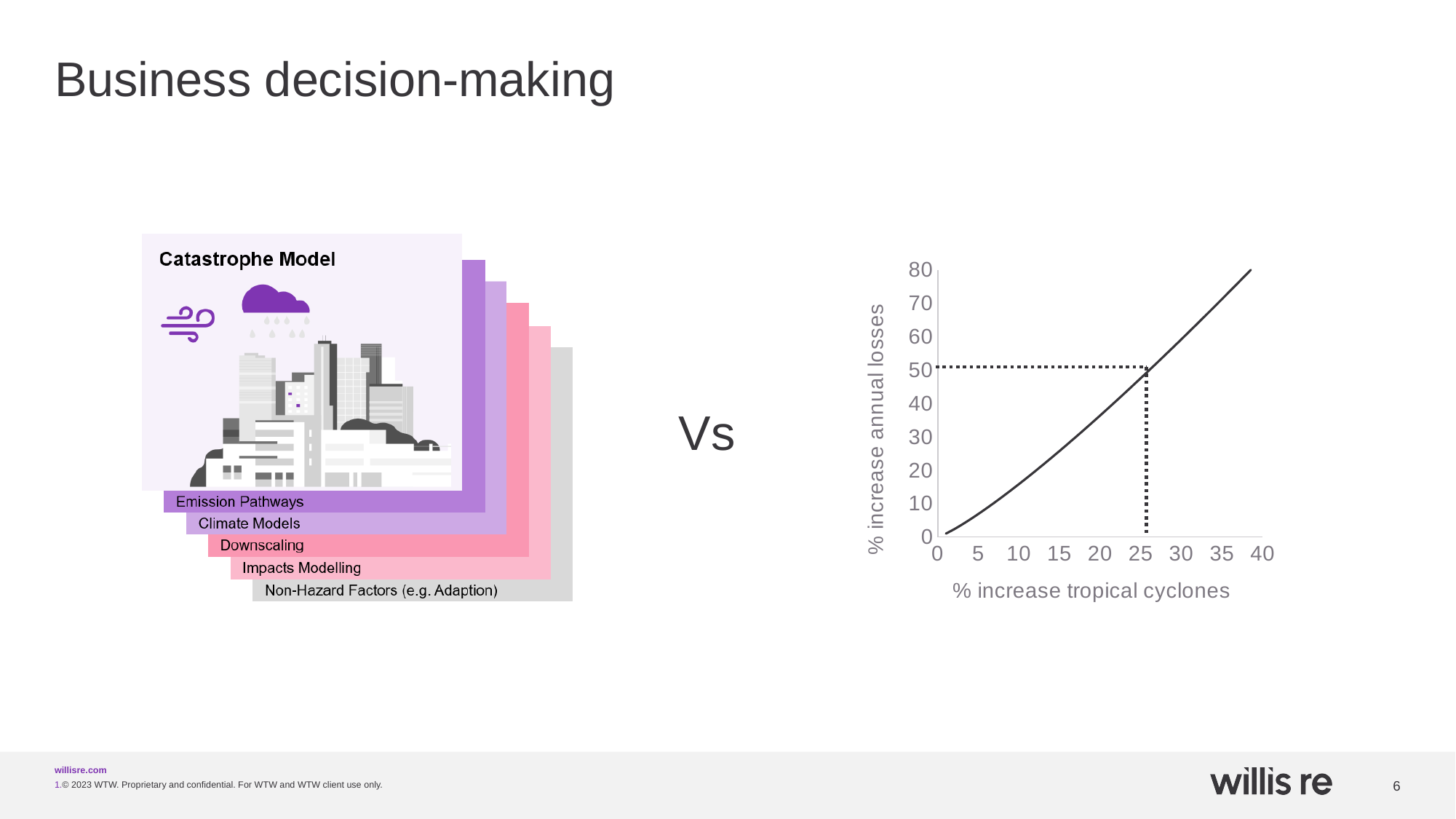
What is the title of the x axis of the chart? % increase tropical cyclones Is the % increase in annual losses at a 30% increase in tropical cyclones greater or less than 50? greater Is the % increase in annual losses at a 10% increase in tropical cyclones greater or less than 30? less Do the values on the chart rise or fall as the % increase in tropical cyclones grows? rise Is the % increase in annual losses at a 35% increase in tropical cyclones greater or less than 60? greater Which is larger on the chart: the % increase in annual losses at a 10% increase in tropical cyclones or at a 30% increase? at a 30% increase What is the highest value shown on the y axis of the chart? 80 What y-axis value does the horizontal dotted line on the chart mark? 50 What kind of chart is shown on the right of the slide? line chart What is the title of the y axis of the chart? % increase annual losses